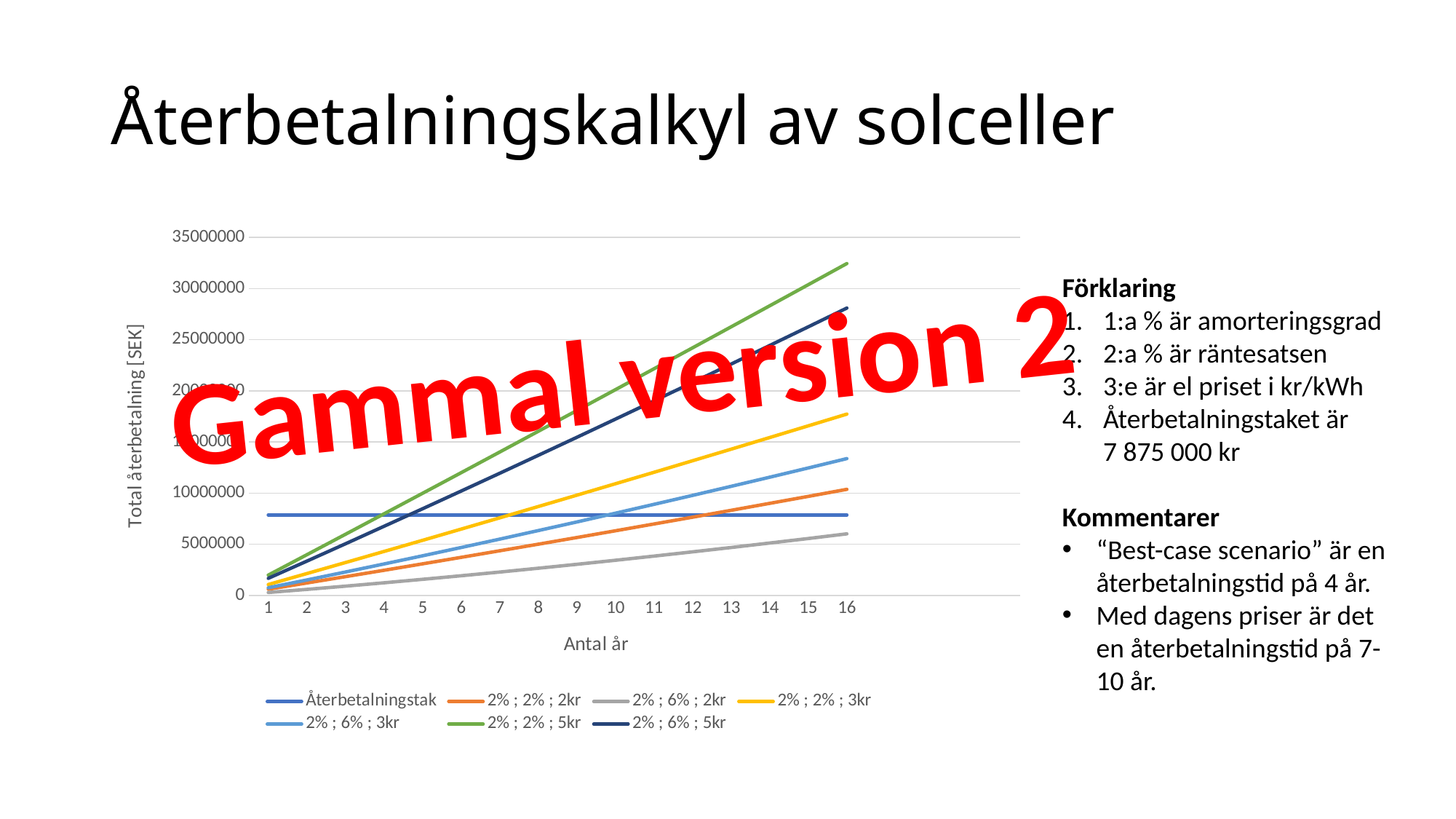
How many series does the chart legend list? 7 Do the values of the series 2% ; 2% ; 3kr rise or fall as the number of years increases? rise What is the title of the y axis of the chart? Total återbetalning [SEK] Is the value for the series 2% ; 2% ; 5kr at year 16 greater or less than 30000000? greater At year 16, which series has the larger value: 2% ; 2% ; 5kr or 2% ; 6% ; 5kr? 2% ; 2% ; 5kr What kind of chart is shown on the slide? line chart Which series has the highest value at year 16? 2% ; 2% ; 5kr Is the value of the Återbetalningstak line greater or less than 10000000? less Is the value for the series 2% ; 6% ; 5kr at year 16 greater or less than 30000000? less Which series has the lowest value at year 16? 2% ; 6% ; 2kr How many years are shown along the x axis of the chart? 16